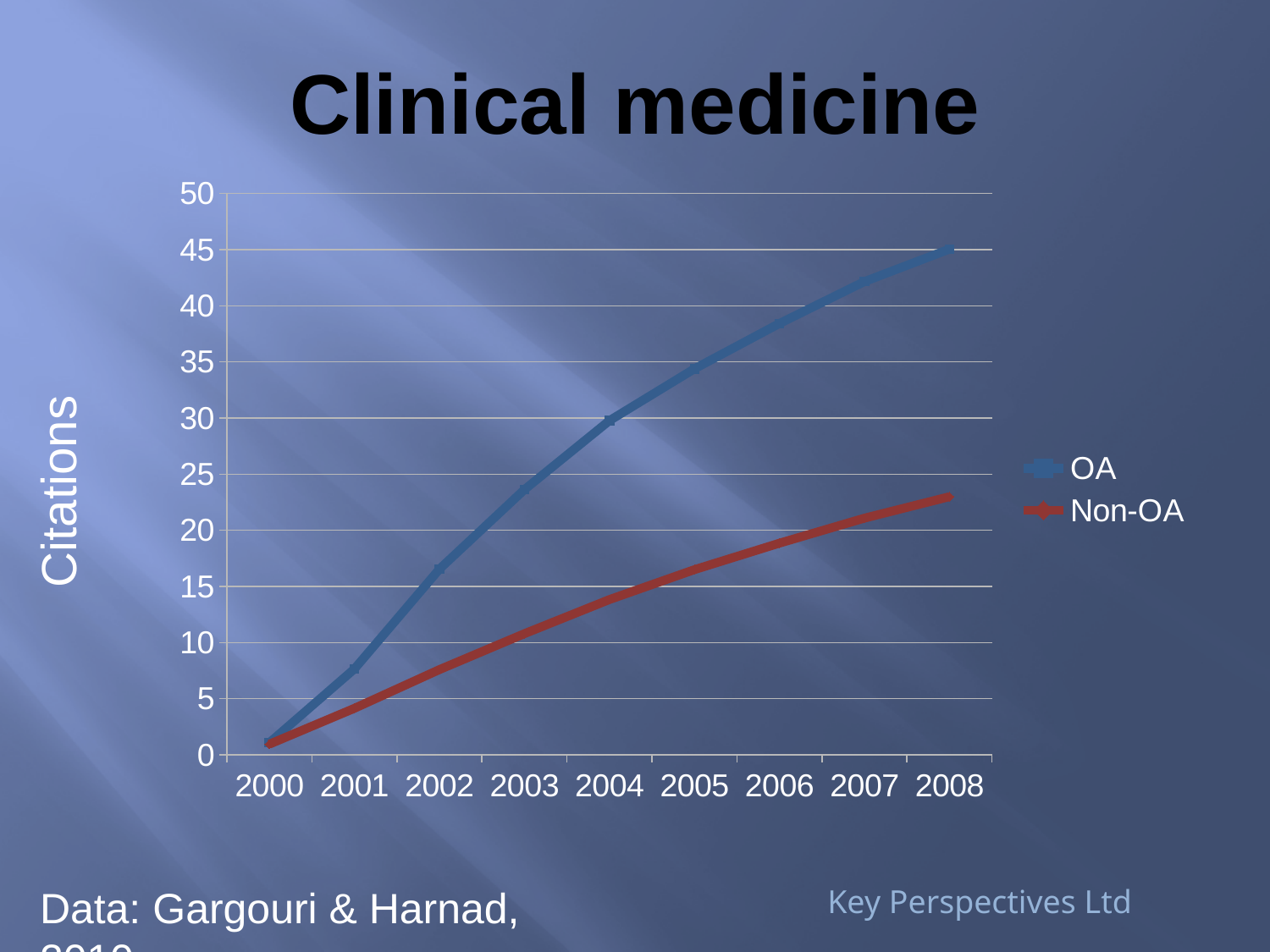
Is the Non-OA value for 2004 greater or less than 20? less What kind of chart is shown on the slide? line chart Do the OA citations rise or fall from 2000 to 2008? rise In 2008, which series has more citations, OA or Non-OA? OA How many series does the legend list? 2 In which year is the OA series at its highest? 2008 In which year is the Non-OA series at its lowest? 2000 Is the Non-OA value for 2008 greater or less than 25? less Is the OA value for 2004 greater or less than 25? greater What is the label on the y axis? Citations How many years are shown along the x axis? 9